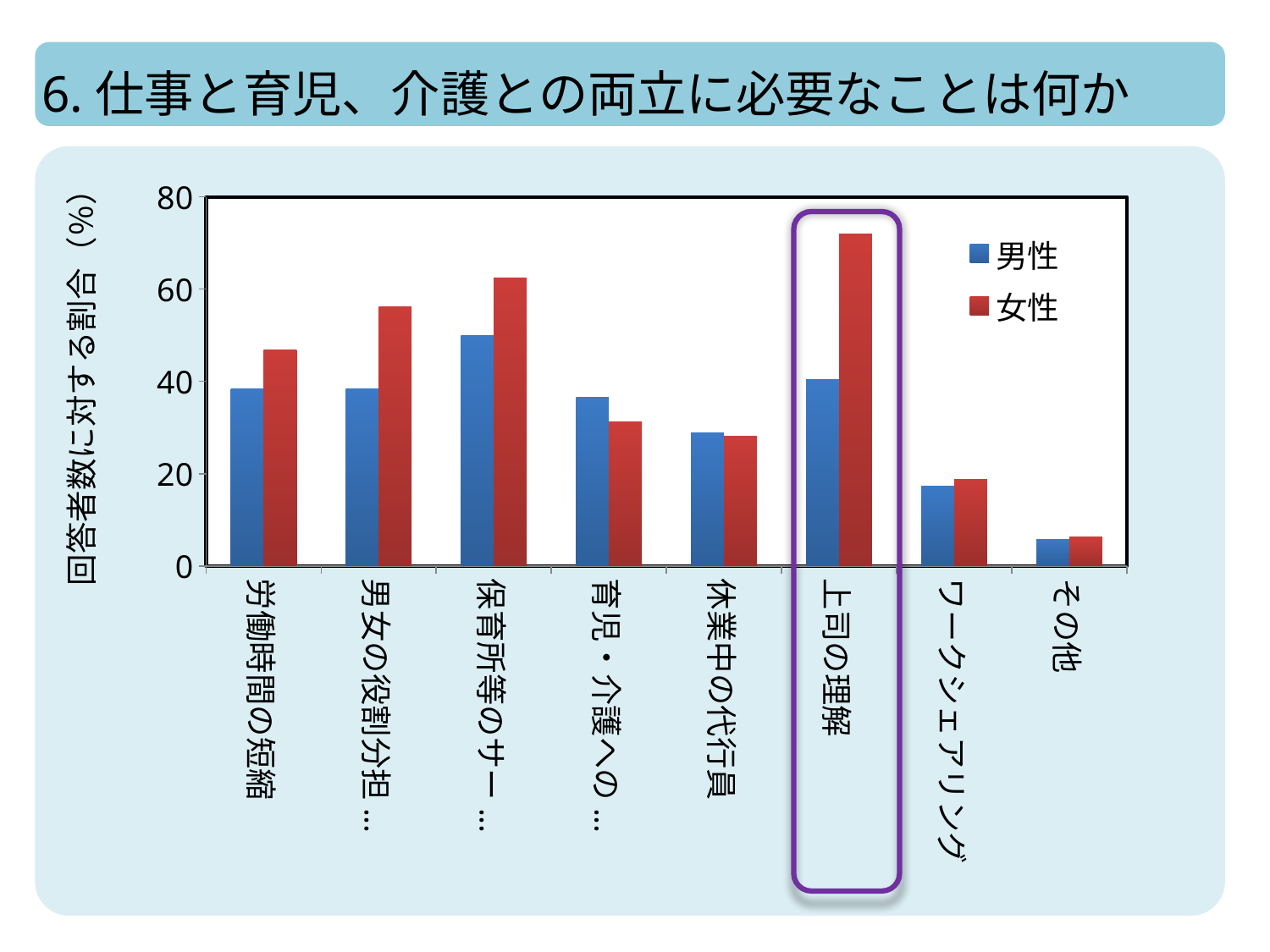
What kind of chart is shown on the slide? bar chart Which category has the lowest value for 女性? その他 Is the value for 男性 in ワークシェアリング greater or less than 20? less Is the value for 女性 in 男女の役割分担… greater or less than 40? greater How many categories are shown on the x axis? 8 In 上司の理解, which series has the larger value, 男性 or 女性? 女性 Which category has the highest value for 女性? 上司の理解 Which category has the highest value for 男性? 保育所等のサー… In 育児・介護への…, which series has the larger value, 男性 or 女性? 男性 Is the value for 女性 in 上司の理解 greater or less than 60? greater How many series does the legend list? 2 Which category is highlighted with a purple outline on the chart? 上司の理解